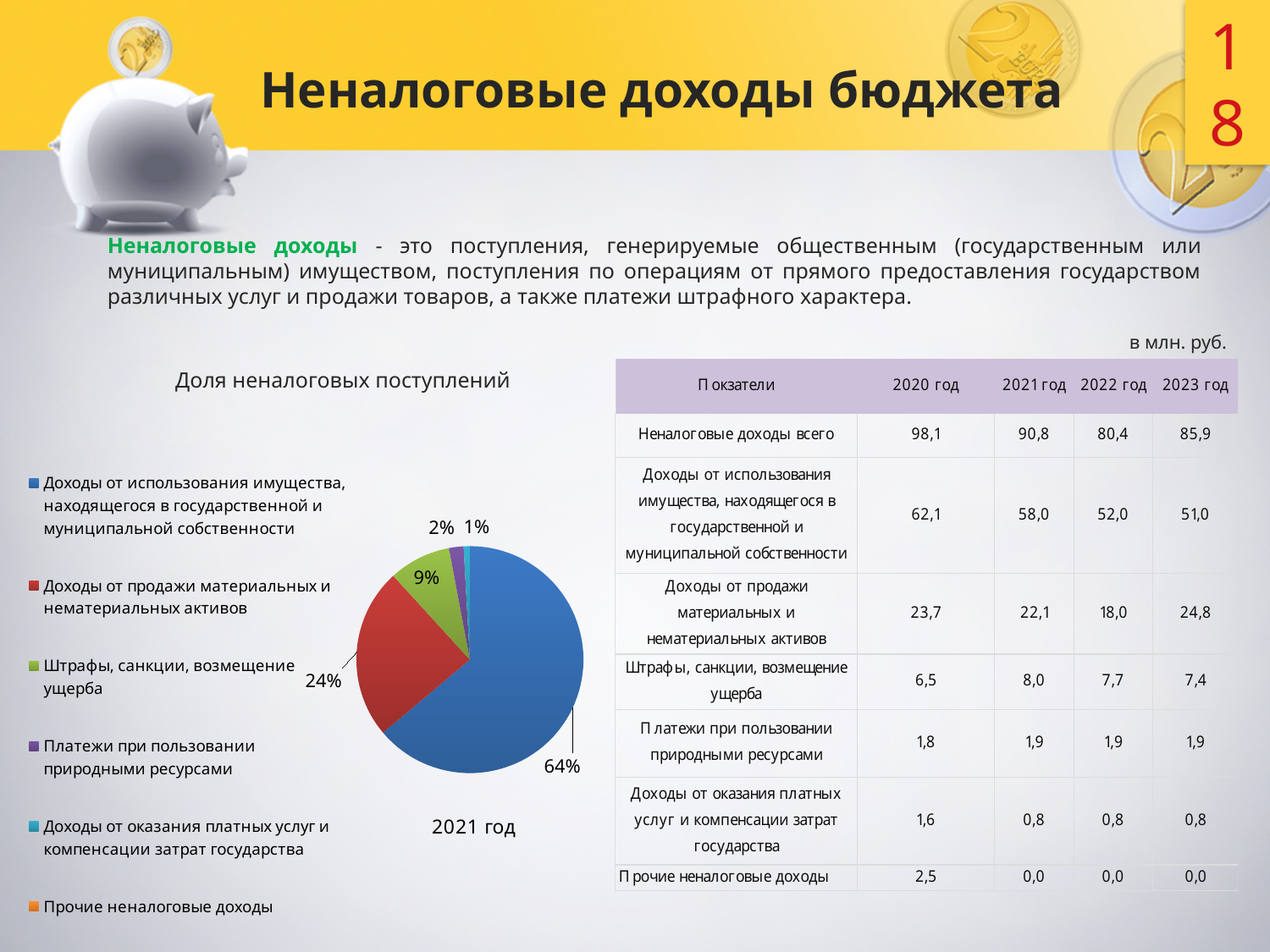
In the pie chart, what share is shown for "Штрафы, санкции, возмещение ущерба"? 9% How many entries does the legend of the pie chart list? 6 In the pie chart, what share is shown for "Платежи при пользовании природными ресурсами"? 2% Which category has the largest slice in the pie chart "Доля неналоговых поступлений"? Доходы от использования имущества, находящегося в государственной и муниципальной собственности What is the title of the pie chart on the slide? Доля неналоговых поступлений In the pie chart, how many percentage points larger is the share for "Доходы от использования имущества" than the share for "Доходы от продажи материальных и нематериальных активов"? 40 In the pie chart, which is larger: the share for "Штрафы, санкции, возмещение ущерба" or the share for "Платежи при пользовании природными ресурсами"? Штрафы, санкции, возмещение ущерба In the pie chart, what share is shown for "Доходы от использования имущества, находящегося в государственной и муниципальной собственности"? 64% Which year does the pie chart "Доля неналоговых поступлений" represent? 2021 год In the pie chart, what share is shown for "Доходы от оказания платных услуг и компенсации затрат государства"? 1% In the pie chart, what share is shown for "Доходы от продажи материальных и нематериальных активов"? 24% What kind of chart is shown under the title "Доля неналоговых поступлений"? pie chart